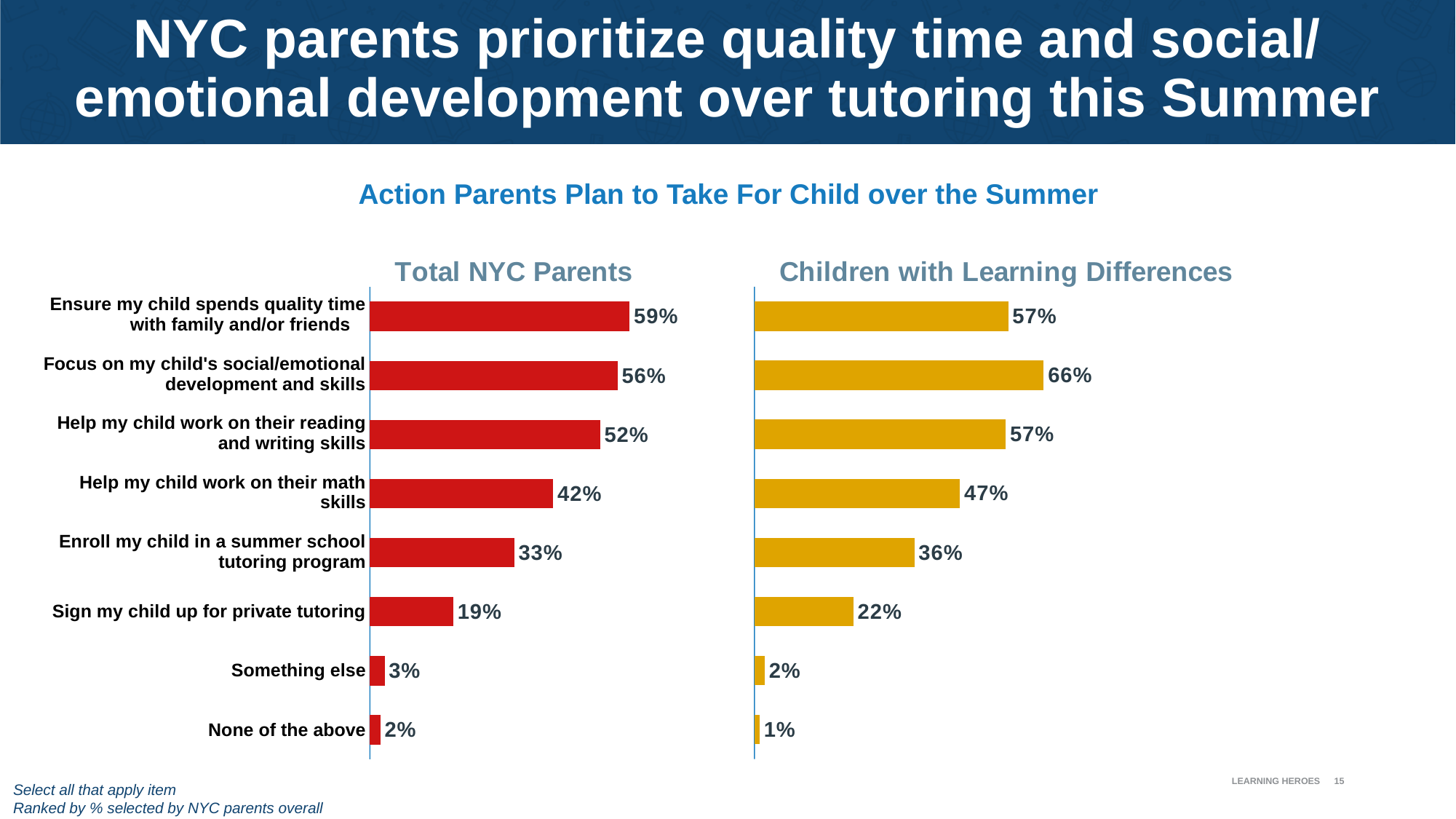
In the Total NYC Parents chart, which action has the highest percentage? Ensure my child spends quality time with family and/or friends What type of chart is used on this slide? Bar chart How many action categories are shown in each chart? 8 What colour are the bars in the Children with Learning Differences chart? Gold/yellow What is the difference between the Children with Learning Differences value and the Total NYC Parents value for 'Focus on my child's social/emotional development and skills'? 10 percentage points In the Children with Learning Differences chart, which action has the highest percentage? Focus on my child's social/emotional development and skills In the Total NYC Parents chart, which category has the lowest percentage? None of the above In the Children with Learning Differences chart, what is the value for 'Sign my child up for private tutoring'? 22% In the Total NYC Parents chart, what percentage of parents plan to ensure their child spends quality time with family and/or friends? 59% For 'Help my child work on their reading and writing skills', which group has the larger value: Total NYC Parents or Children with Learning Differences? Children with Learning Differences In the Total NYC Parents chart, what is the difference between 'Help my child work on their math skills' and 'Enroll my child in a summer school tutoring program'? 9 percentage points In the Children with Learning Differences chart, what percentage plan to focus on their child's social/emotional development and skills? 66%